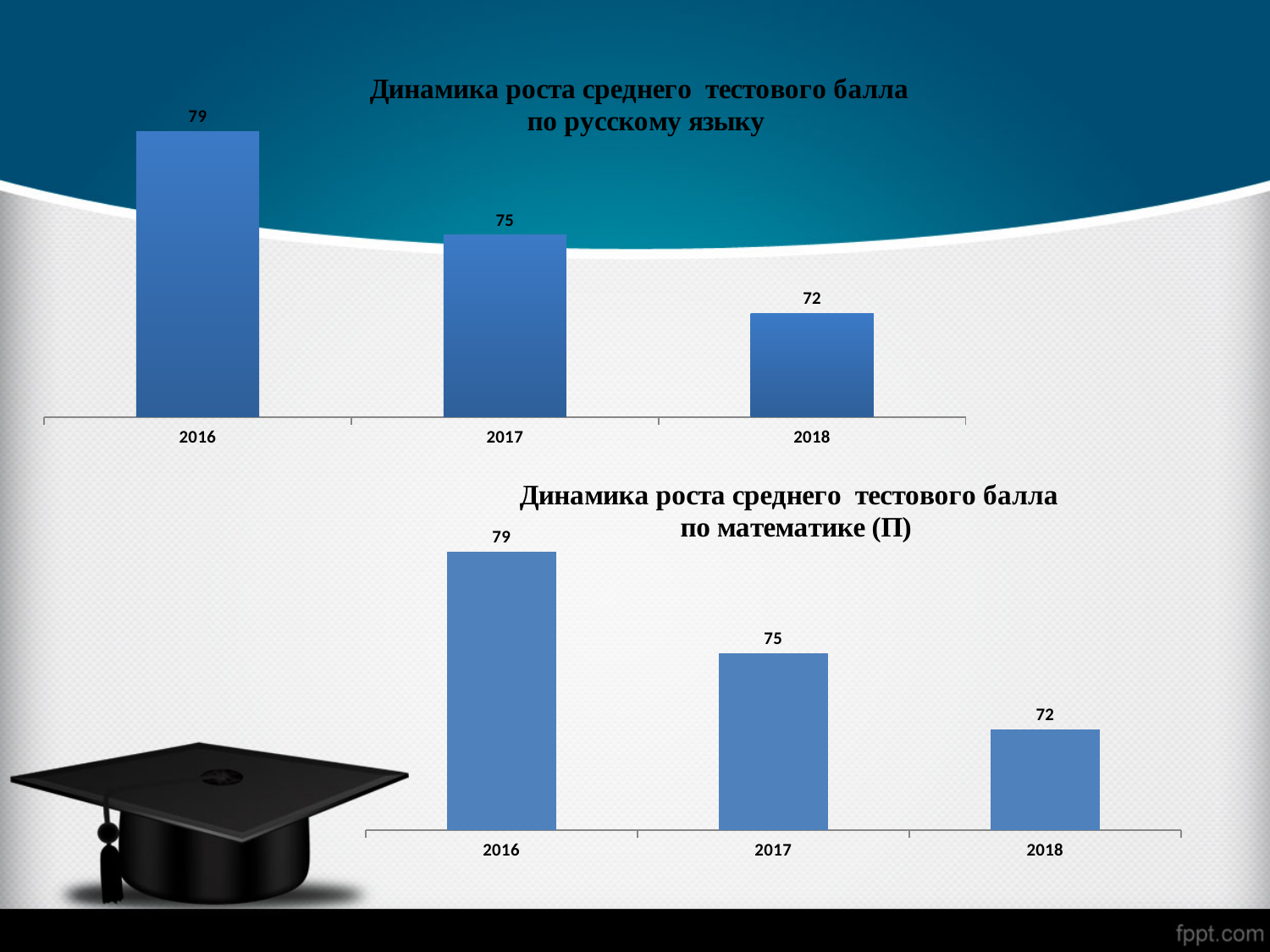
In the bottom chart (mathematics), what is the difference between the 2016 and 2017 values? 4 In the top chart (Russian language), what is the value for 2016? 79 How many years are shown in the top chart (Russian language)? 3 In the top chart (Russian language), do the values rise or fall from 2016 to 2018? fall In the top chart (Russian language), what is the difference between the 2016 and 2018 values? 7 In the top chart (Russian language), which year has the highest value? 2016 What is the title of the bottom chart? Динамика роста среднего тестового балла по математике (П) In the bottom chart (mathematics), what is the value for 2017? 75 In the bottom chart (mathematics), which year has the lowest value? 2018 In the bottom chart (mathematics), which is larger, the value for 2017 or the value for 2018? 2017 What type of chart is the bottom chart (mathematics)? bar chart In the top chart (Russian language), what is the value for 2018? 72